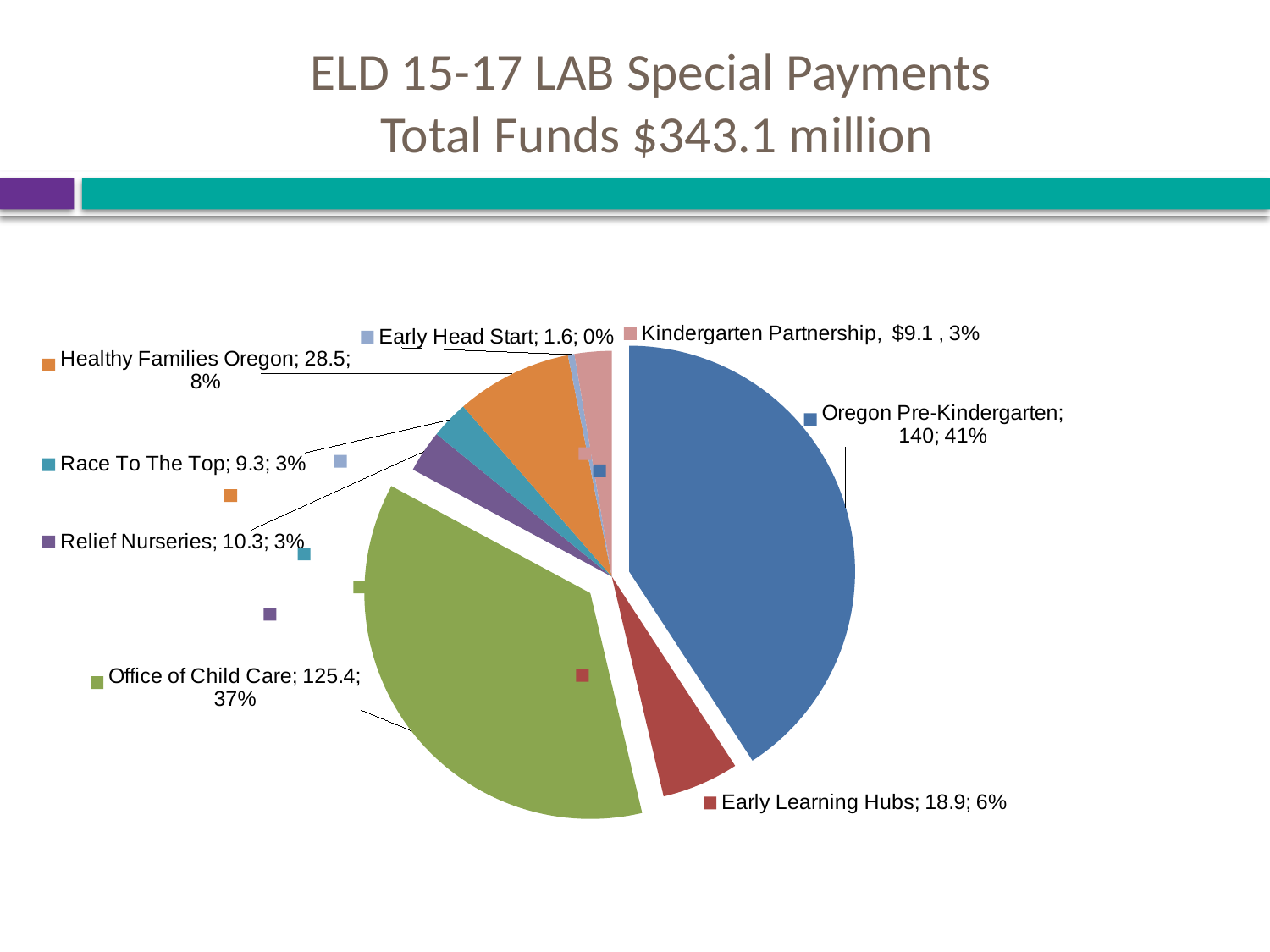
What is the value for Oregon Pre-Kindergarten? 140 What type of chart is shown on the slide? Pie chart What is the value for Early Learning Hubs? 18.9 What is the difference between the values for Oregon Pre-Kindergarten and Office of Child Care? 14.6 What share of the pie does Office of Child Care represent? 37% Which category has the largest slice of the pie? Oregon Pre-Kindergarten Which is larger, Relief Nurseries or Race To The Top? Relief Nurseries What share of the pie does Oregon Pre-Kindergarten represent? 41% How many categories are shown in the pie chart? 8 What is the value for Healthy Families Oregon? 28.5 Which category has the smallest slice of the pie? Early Head Start What is the value for Office of Child Care? 125.4